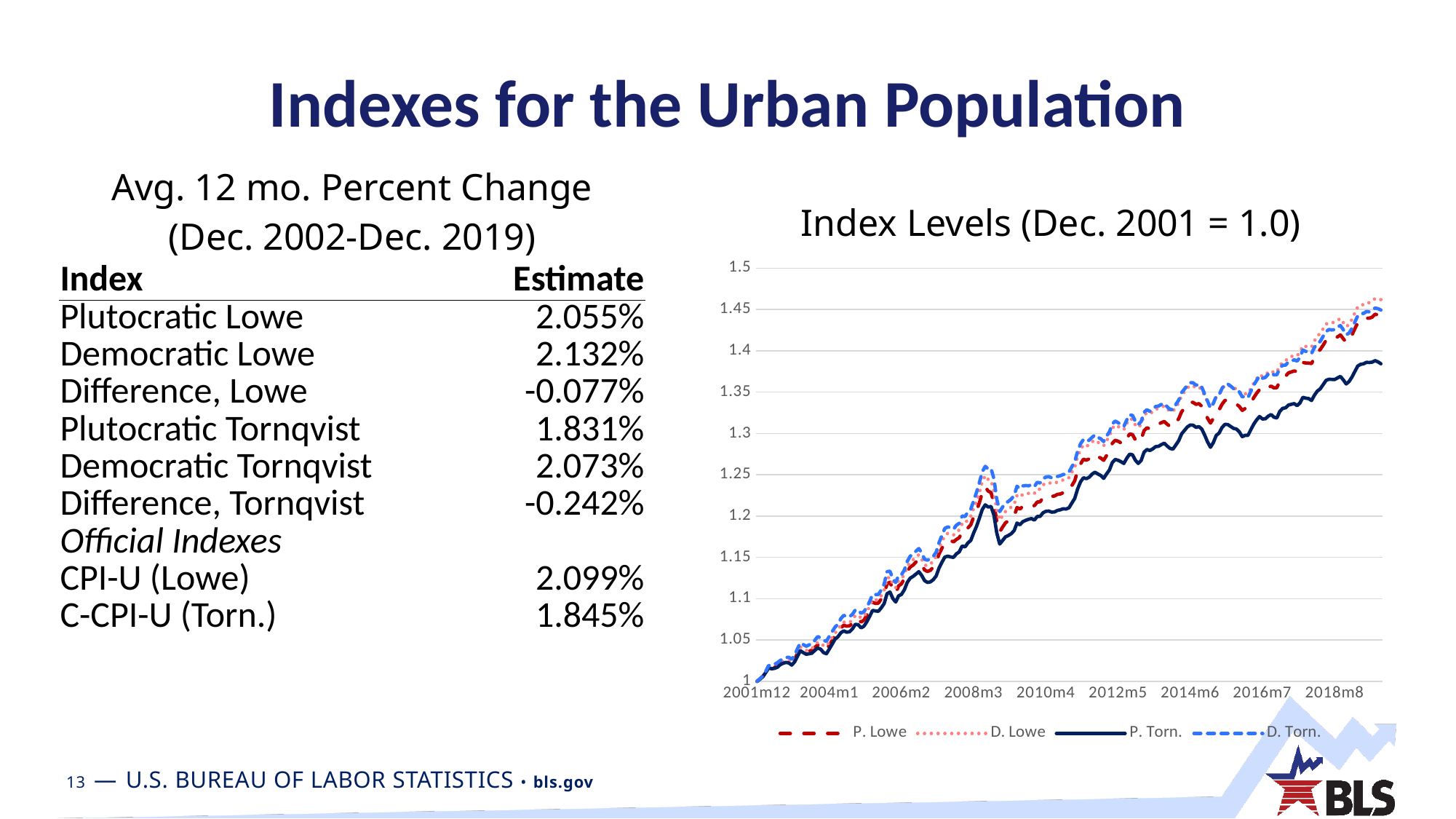
What is the title of the chart on the right of the slide? Index Levels (Dec. 2001 = 1.0) In the Index Levels chart, do the index values generally rise or fall from 2001m12 to 2018m8? rise What kind of chart is shown on the slide? line chart In the Index Levels chart, what is the value of the series at 2001m12? 1 How many series does the legend of the Index Levels chart list? 4 In the Index Levels chart, at the right end of the chart, is the value for P. Torn. greater or less than 1.4? less How many x-axis tick labels are shown on the Index Levels chart? 9 In the Index Levels chart, at the right end of the chart, which is larger: P. Torn. or D. Torn.? D. Torn. In the Index Levels chart, which series is lowest at the right end of the chart? P. Torn. In the Index Levels chart, around 2008m3, is the value for P. Torn. greater or less than 1.25? less Which series are listed in the legend of the Index Levels chart? P. Lowe, D. Lowe, P. Torn., D. Torn. In the Index Levels chart, at the right end of the chart, is the value for D. Lowe greater or less than 1.4? greater